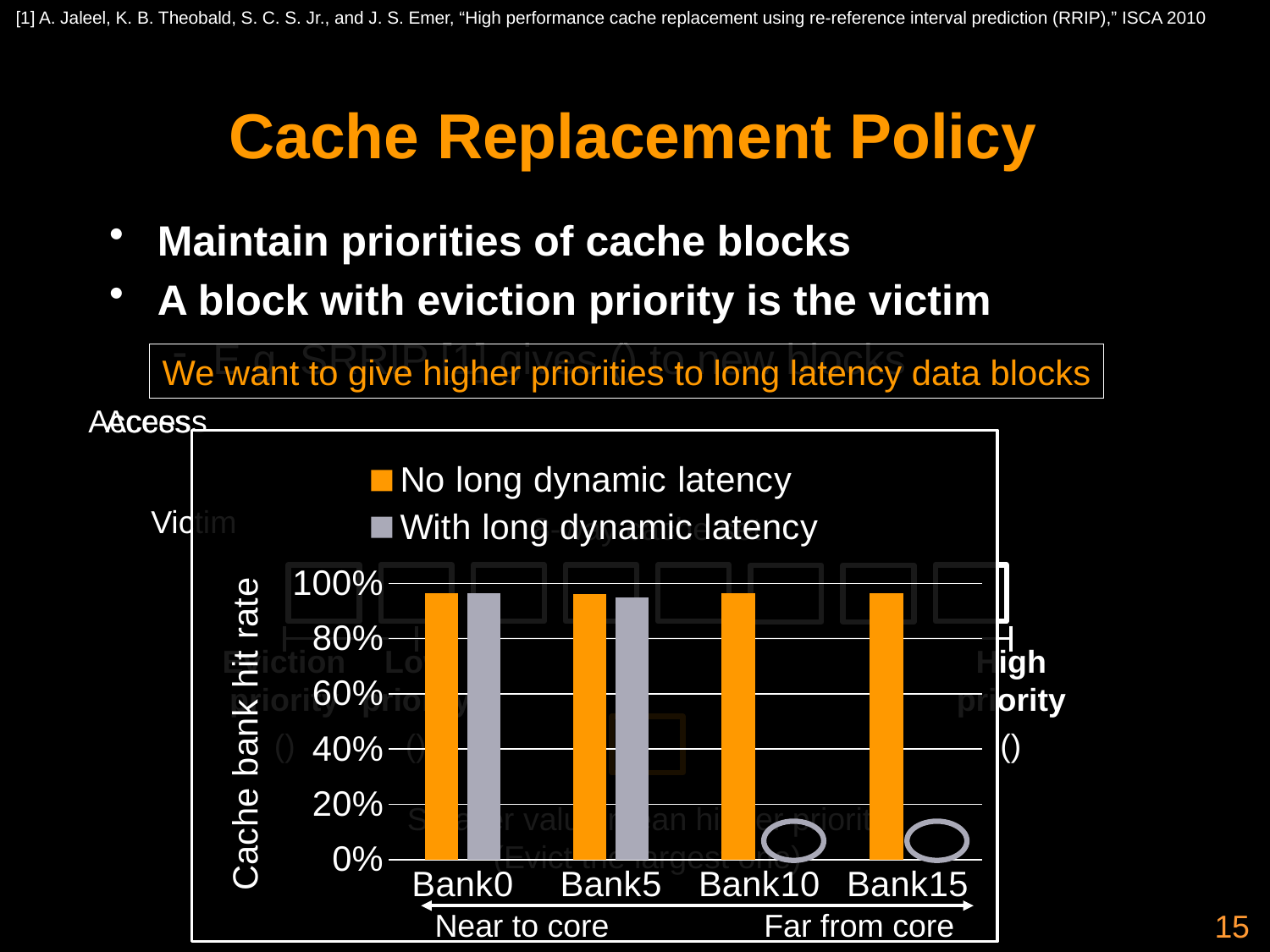
Which legend entry is shown in orange? No long dynamic latency Is the 'With long dynamic latency' value for Bank10 greater or less than 20%? less What is the label of the chart's y axis? Cache bank hit rate What kind of chart is shown on the slide? bar chart How many cache banks are shown on the x axis of the chart? 4 How many series does the chart legend list? 2 For Bank10, which series has the larger cache bank hit rate: 'No long dynamic latency' or 'With long dynamic latency'? No long dynamic latency Is the 'No long dynamic latency' value for Bank15 greater or less than 60%? greater Is the 'No long dynamic latency' value for Bank0 greater or less than 80%? greater In the 'With long dynamic latency' series, which has the larger value: Bank0 or Bank15? Bank0 Do the 'With long dynamic latency' values rise or fall going from Bank0 to Bank15? fall